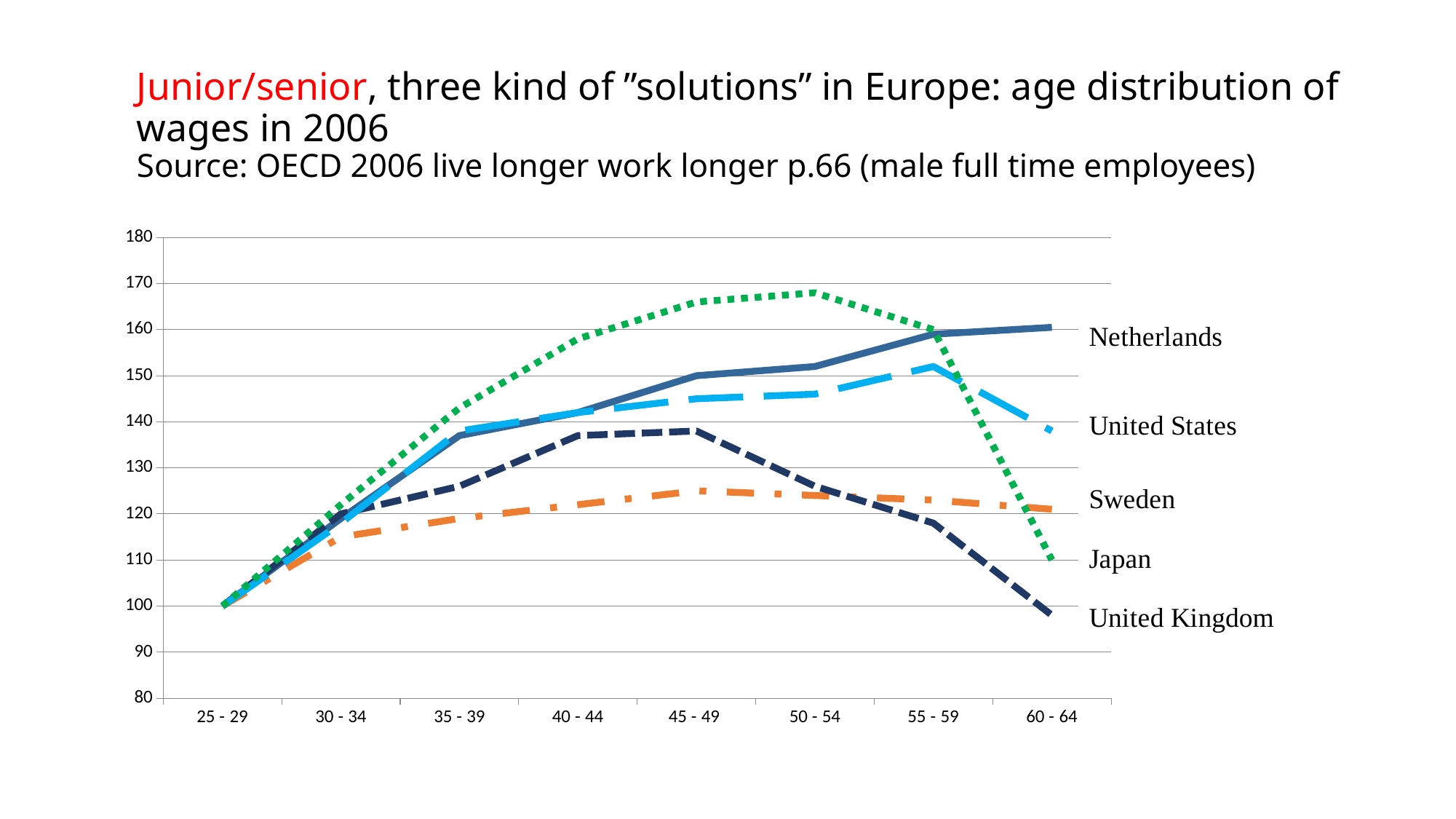
Does the Netherlands line rise or fall from the 25 - 29 age group to the 60 - 64 age group? rise Which country has the lowest value in the 60 - 64 age group? United Kingdom What kind of chart is shown on the slide? line chart Which country has the highest value in the 60 - 64 age group? Netherlands How many series (countries) are plotted on the chart? 5 Which country has the highest value in the 50 - 54 age group? Japan Is the value for Japan in the 50 - 54 age group greater or less than 160? greater Is the value for Netherlands in the 60 - 64 age group greater or less than 150? greater How many age groups are shown along the x axis? 8 Is the value for Sweden in the 45 - 49 age group greater or less than 130? less What is the value for Netherlands in the 25 - 29 age group? 100 In the 45 - 49 age group, which is larger: the value for Netherlands or the value for Sweden? Netherlands